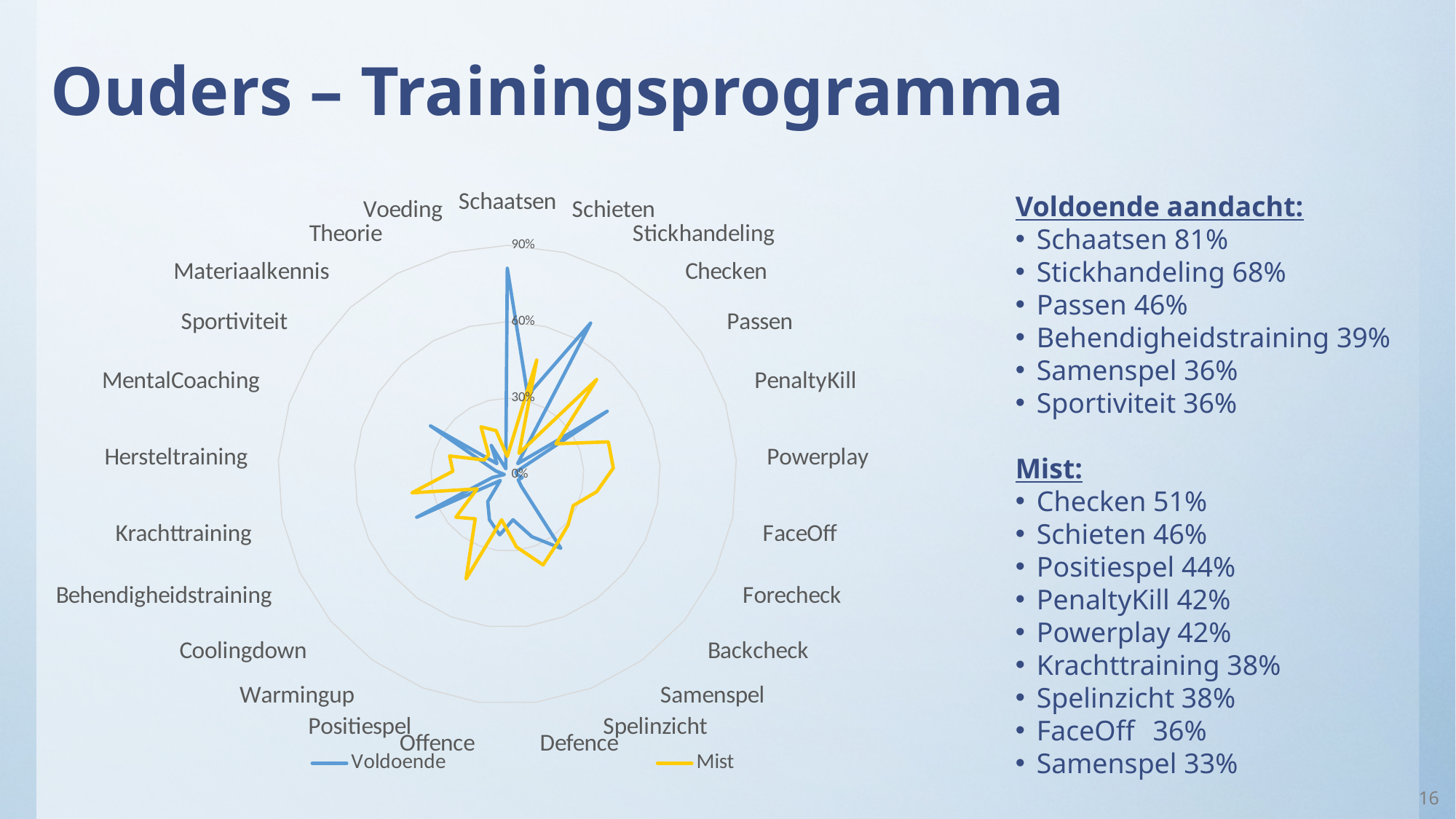
Is the Mist value for Checken greater or less than 30%? greater Is the Voldoende value for Schaatsen greater or less than 90%? less What are the two series named in the chart legend? Voldoende and Mist Is the Voldoende value for Schaatsen greater or less than 60%? greater How many series does the chart's legend list? 2 Which colour represents the Mist series in the chart? Yellow Which category has the highest Voldoende value in the chart? Schaatsen For Checken, which series has the larger value, Voldoende or Mist? Mist For Schaatsen, which series has the larger value, Voldoende or Mist? Voldoende What kind of chart is shown on the slide? Radar chart How many categories are plotted around the radar chart? 25